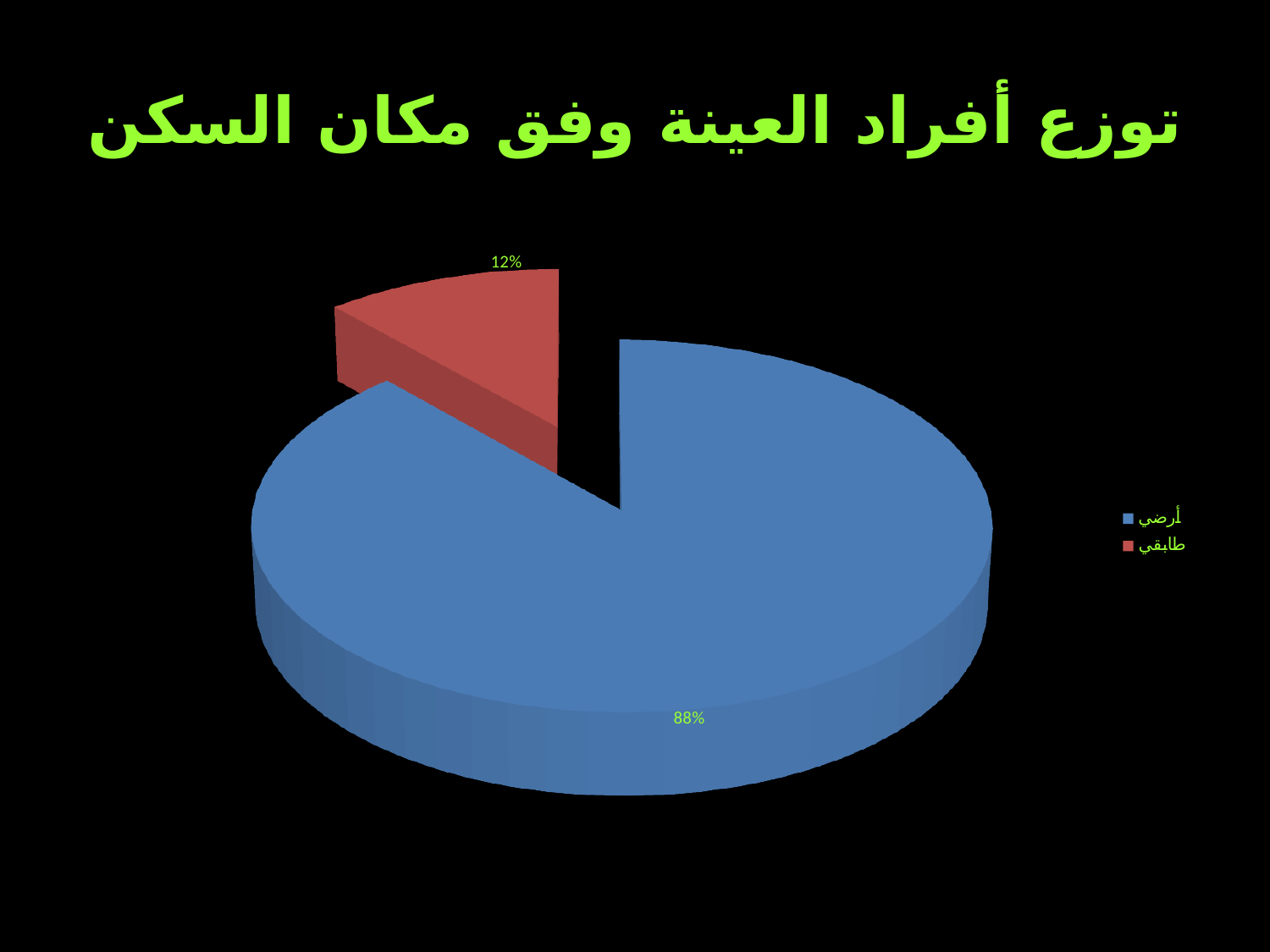
What is the title of the chart? توزع أفراد العينة وفق مكان السكن Which is larger, the value for أرضي or the value for طابقي? أرضي How many entries does the legend list? 2 What is the value for طابقي? 12% What share of the pie does the طابقي slice represent? 12% Which category has the smallest slice? طابقي What is the difference between the values for أرضي and طابقي? 76% What is the value for أرضي? 88% What colour is the slice for طابقي? red How many slices does the pie chart have? 2 What kind of chart is shown on the slide? pie chart Which category has the largest slice? أرضي